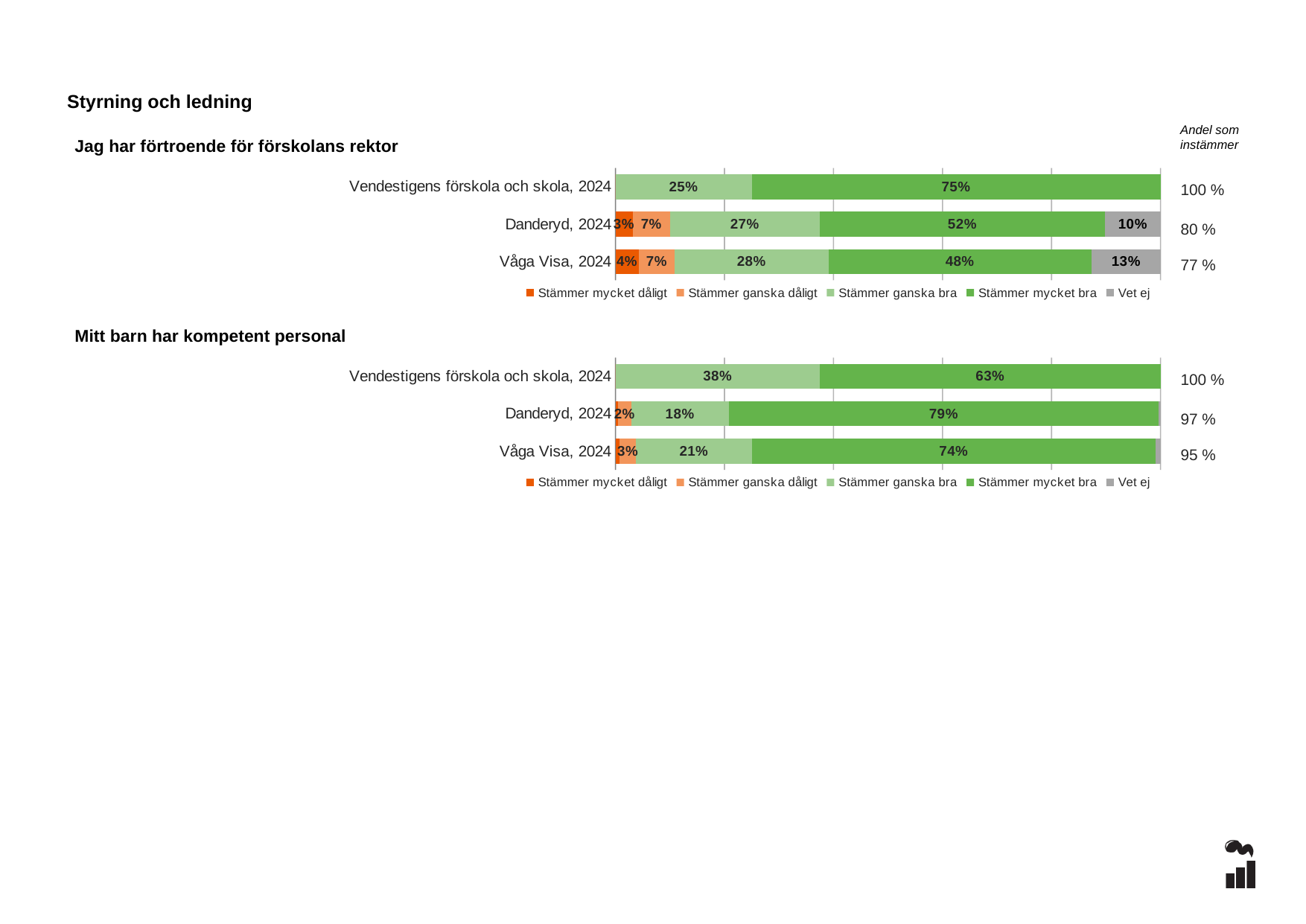
How many categories are shown in the chart 'Mitt barn har kompetent personal'? 3 In the chart 'Jag har förtroende för förskolans rektor', what is the 'Andel som instämmer' for Danderyd, 2024? 80 % In the chart 'Jag har förtroende för förskolans rektor', which category has the highest 'Stämmer mycket bra' value? Vendestigens förskola och skola, 2024 In the chart 'Jag har förtroende för förskolans rektor', what is the 'Stämmer mycket bra' value for Vendestigens förskola och skola, 2024? 75% In the chart 'Mitt barn har kompetent personal', which category has the lowest 'Andel som instämmer'? Våga Visa, 2024 How many series does the legend of the chart 'Jag har förtroende för förskolans rektor' list? 5 In the chart 'Mitt barn har kompetent personal', what is the 'Stämmer mycket bra' value for Danderyd, 2024? 79% What kind of chart is 'Jag har förtroende för förskolans rektor'? Stacked bar chart In the chart 'Jag har förtroende för förskolans rektor', what is the 'Vet ej' value for Våga Visa, 2024? 13% In the chart 'Jag har förtroende för förskolans rektor', what is the difference between the 'Stämmer mycket bra' values for Danderyd, 2024 and Våga Visa, 2024? 4 percentage points In the chart 'Mitt barn har kompetent personal', is the 'Stämmer mycket bra' value larger for Våga Visa, 2024 or for Vendestigens förskola och skola, 2024? Våga Visa, 2024 In the chart 'Mitt barn har kompetent personal', what is the 'Stämmer ganska bra' value for Vendestigens förskola och skola, 2024? 38%